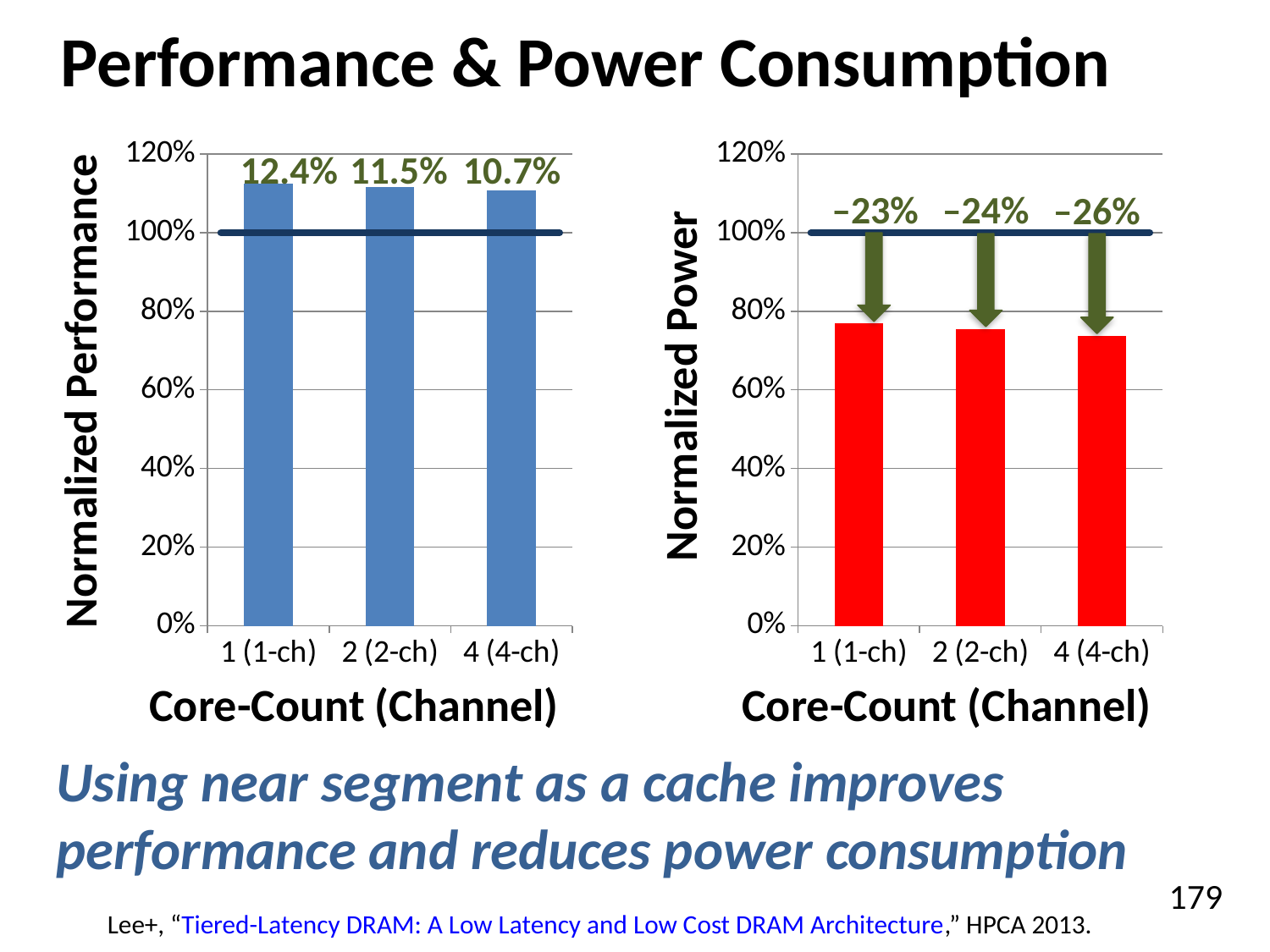
In the Normalized Power chart on the right, is the bar for 1 (1-ch) greater or less than 80%? less In the Normalized Power chart on the right, which core-count category has the largest annotated power reduction? 4 (4-ch) In the Normalized Performance chart on the left, what percentage improvement is annotated above the bar for 4 (4-ch)? 10.7% In the Normalized Performance chart on the left, what percentage improvement is annotated above the bar for 1 (1-ch)? 12.4% In the Normalized Performance chart on the left, is the bar for 2 (2-ch) greater or less than 100%? greater In the Normalized Performance chart on the left, which core-count category has the largest annotated improvement? 1 (1-ch) What kind of chart is the Normalized Performance chart on the left? bar chart How many core-count categories are shown on the x axis of the Normalized Power chart on the right? 3 In the Normalized Power chart on the right, do the bar values rise or fall as the core count increases along the x axis? fall In the Normalized Power chart on the right, is the bar for 4 (4-ch) greater or less than 60%? greater In the Normalized Power chart on the right, what percentage change is annotated above the bar for 2 (2-ch)? –24% In the Normalized Power chart on the right, what percentage change is annotated above the bar for 4 (4-ch)? –26%